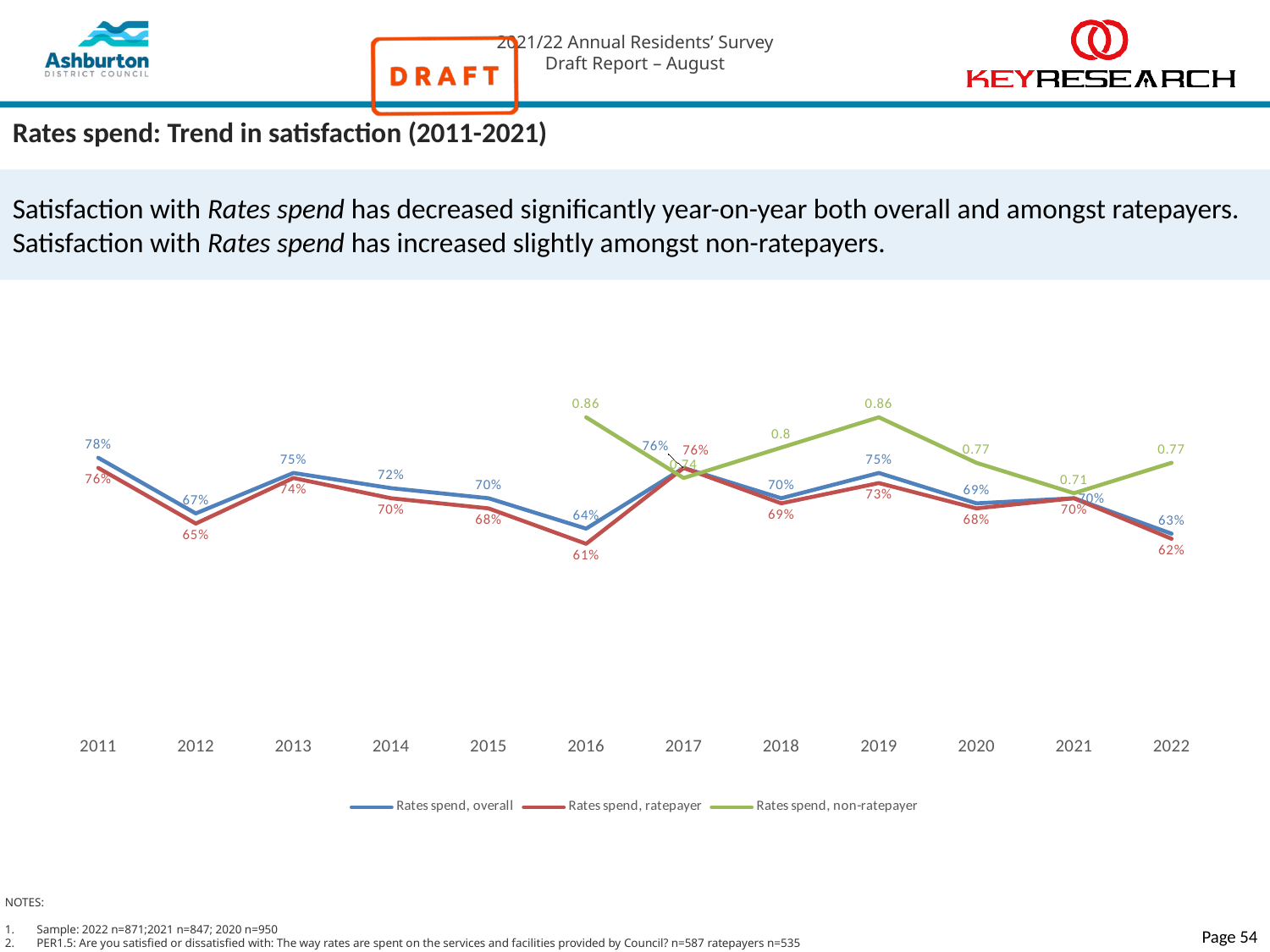
What is the value for Rates spend, overall in 2011? 78% What kind of chart is shown on the slide? Line chart In which year is Rates spend, non-ratepayer at its lowest? 2021 In which year is Rates spend, overall at its highest? 2011 In 2019, which is larger: Rates spend, overall or Rates spend, ratepayer? Rates spend, overall What is the value for Rates spend, non-ratepayer in 2018? 0.8 How many series does the legend list? 3 What is the value for Rates spend, ratepayer in 2016? 61% What is the difference between Rates spend, overall in 2011 and in 2022? 15 percentage points Does Rates spend, overall rise or fall from 2013 to 2016? Fall In which year is Rates spend, ratepayer at its lowest? 2016 How many years are shown on the x axis? 12